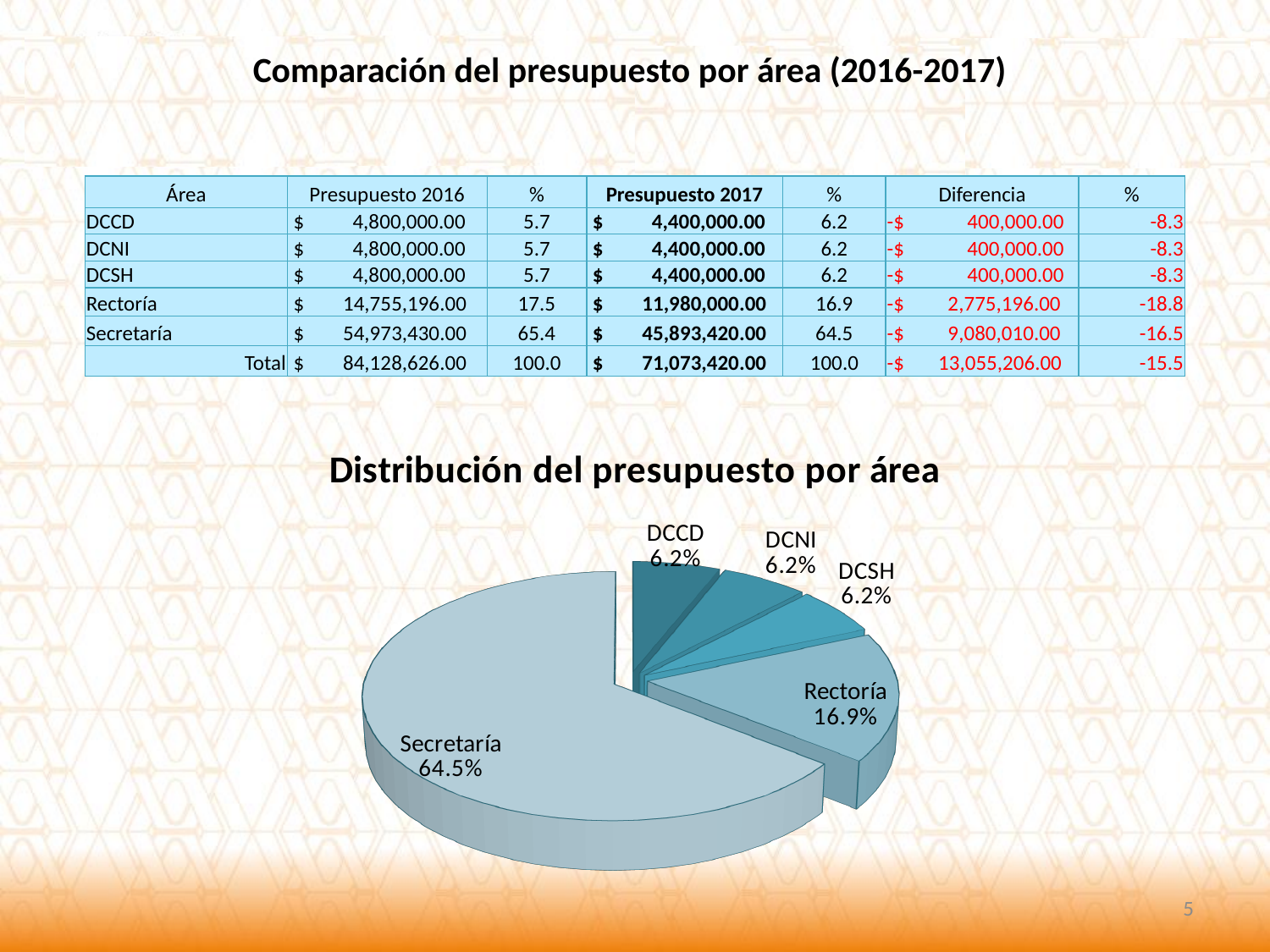
In the pie chart, what share does Rectoría have? 16.9% In the pie chart, what share does DCSH have? 6.2% In the pie chart, what share does DCCD have? 6.2% In the pie chart, what is the difference in percentage points between Secretaría and Rectoría? 47.6 How many slices does the pie chart have? 5 In the pie chart, which is larger, Rectoría or DCNI? Rectoría What is the title of the pie chart on the slide? Distribución del presupuesto por área Which slice of the pie chart is the largest? Secretaría What type of chart is shown under the title "Distribución del presupuesto por área"? Pie chart In the pie chart, what is the combined share of DCCD, DCNI and DCSH? 18.6% In the pie chart, what share does Secretaría have? 64.5% In the pie chart, what is the difference in percentage points between Rectoría and DCSH? 10.7